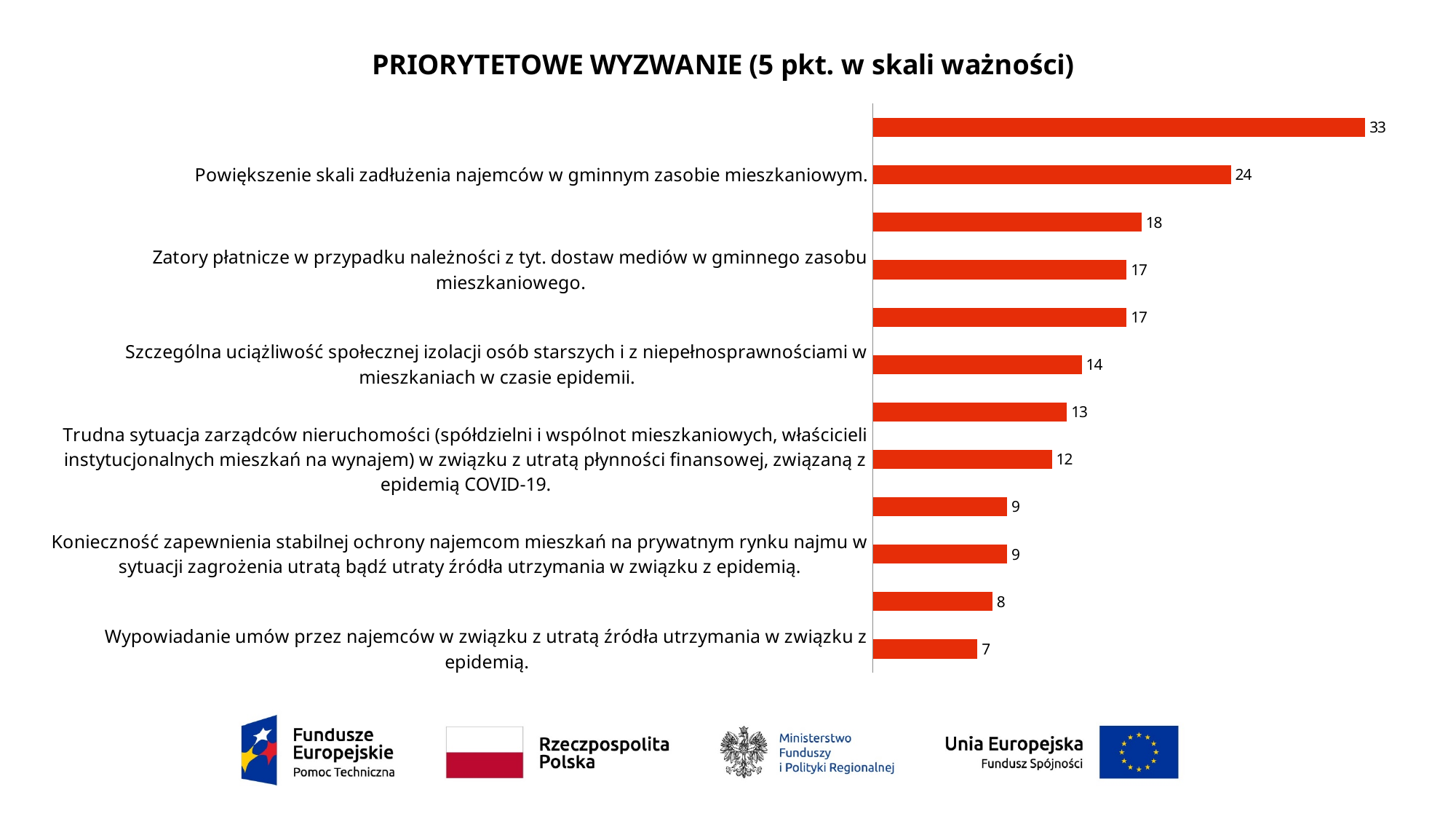
What is the value for "Zatory płatnicze w przypadku należności z tyt. dostaw mediów w gminnego zasobu mieszkaniowego"? 17 What is the value for "Wypowiadanie umów przez najemców w związku z utratą źródła utrzymania w związku z epidemią"? 7 What is the highest value shown on the chart? 33 Which labelled category has the lowest value? Wypowiadanie umów przez najemców w związku z utratą źródła utrzymania w związku z epidemią. What type of chart is shown on the slide? bar chart What is the value for "Szczególna uciążliwość społecznej izolacji osób starszych i z niepełnosprawnościami w mieszkaniach w czasie epidemii"? 14 What is the difference between the value for "Powiększenie skali zadłużenia najemców w gminnym zasobie mieszkaniowym" and the value for "Wypowiadanie umów przez najemców w związku z utratą źródła utrzymania w związku z epidemią"? 17 How many bars are plotted on the chart? 12 What is the title of the chart? PRIORYTETOWE WYZWANIE (5 pkt. w skali ważności) What is the value for "Powiększenie skali zadłużenia najemców w gminnym zasobie mieszkaniowym"? 24 What is the value for "Trudna sytuacja zarządców nieruchomości ... w związku z utratą płynności finansowej, związaną z epidemią COVID-19"? 12 Which is larger: the value for "Szczególna uciążliwość społecznej izolacji osób starszych..." or the value for "Konieczność zapewnienia stabilnej ochrony najemcom mieszkań na prywatnym rynku najmu..."? Szczególna uciążliwość społecznej izolacji osób starszych i z niepełnosprawnościami w mieszkaniach w czasie epidemii.